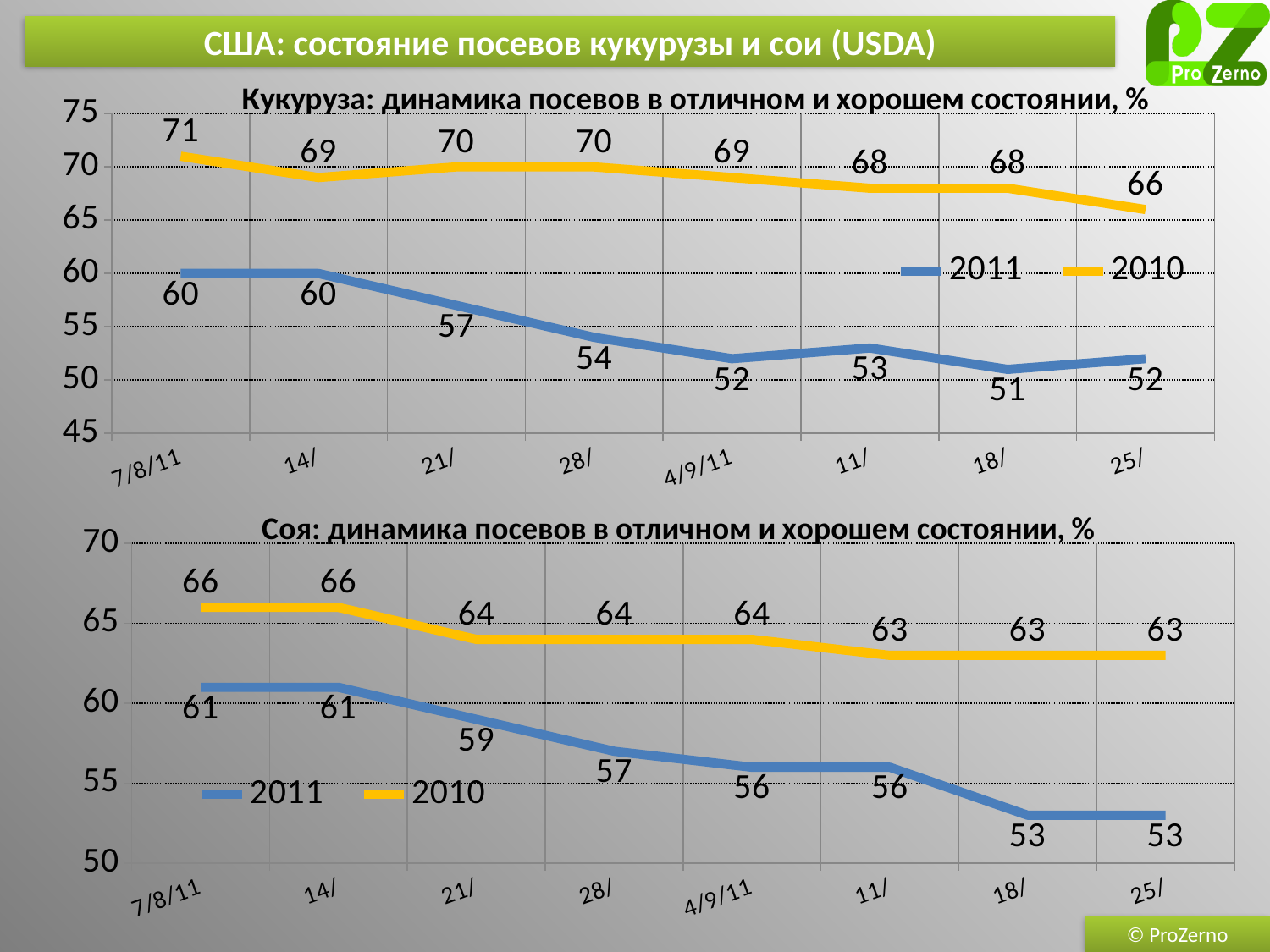
On the soybean chart (Соя), what is the 2011 value at 28/? 57 What type of chart is the soybean chart (Соя)? line chart On the corn chart (Кукуруза), what is the 2010 value at 25/? 66 On the soybean chart (Соя), which series has the higher value at 25/, 2011 or 2010? 2010 On the corn chart (Кукуруза), does the 2011 series generally rise or fall from 7/8/11 to 25/? fall On the corn chart (Кукуруза), how many data points does each series have? 8 On the soybean chart (Соя), what is the difference between the 2011 values at 7/8/11 and 25/? 8 On the corn chart (Кукуруза), what is the difference between the 2010 and 2011 values at 7/8/11? 11 On the soybean chart (Соя), what is the 2010 value at 21/? 64 On the soybean chart (Соя), how many series does the legend list? 2 On the corn chart (Кукуруза), at which x-axis point is the 2011 series lowest? 18/ On the corn chart (Кукуруза), what is the 2011 value at 7/8/11? 60